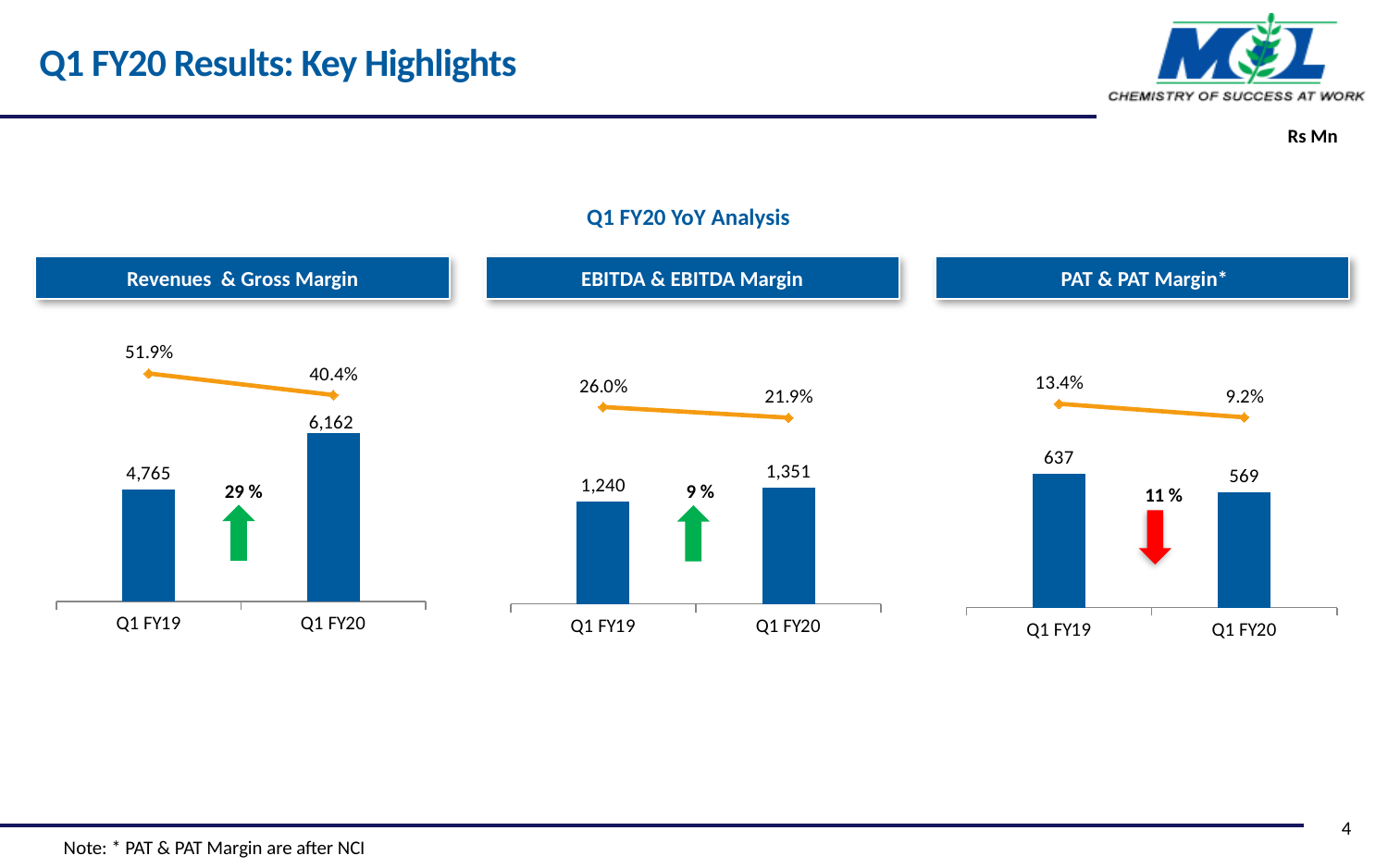
In the PAT & PAT Margin* chart, does the PAT margin rise or fall from Q1 FY19 to Q1 FY20? fall In the EBITDA & EBITDA Margin chart, which quarter has the higher EBITDA? Q1 FY20 In the PAT & PAT Margin* chart, what is the PAT margin for Q1 FY19? 13.4% In the EBITDA & EBITDA Margin chart, what is the EBITDA value for Q1 FY19? 1,240 How many categories are shown on the x axis of the Revenues & Gross Margin chart? 2 In the Revenues & Gross Margin chart, what is the revenue value for Q1 FY20? 6,162 In the PAT & PAT Margin* chart, what is the PAT value for Q1 FY20? 569 In the EBITDA & EBITDA Margin chart, what is the EBITDA margin for Q1 FY20? 21.9% What percentage change is shown between the bars in the EBITDA & EBITDA Margin chart? 9 % In the PAT & PAT Margin* chart, which quarter has the higher PAT, Q1 FY19 or Q1 FY20? Q1 FY19 In the Revenues & Gross Margin chart, what is the difference in revenue between Q1 FY20 and Q1 FY19? 1,397 In the Revenues & Gross Margin chart, what is the gross margin for Q1 FY19? 51.9%